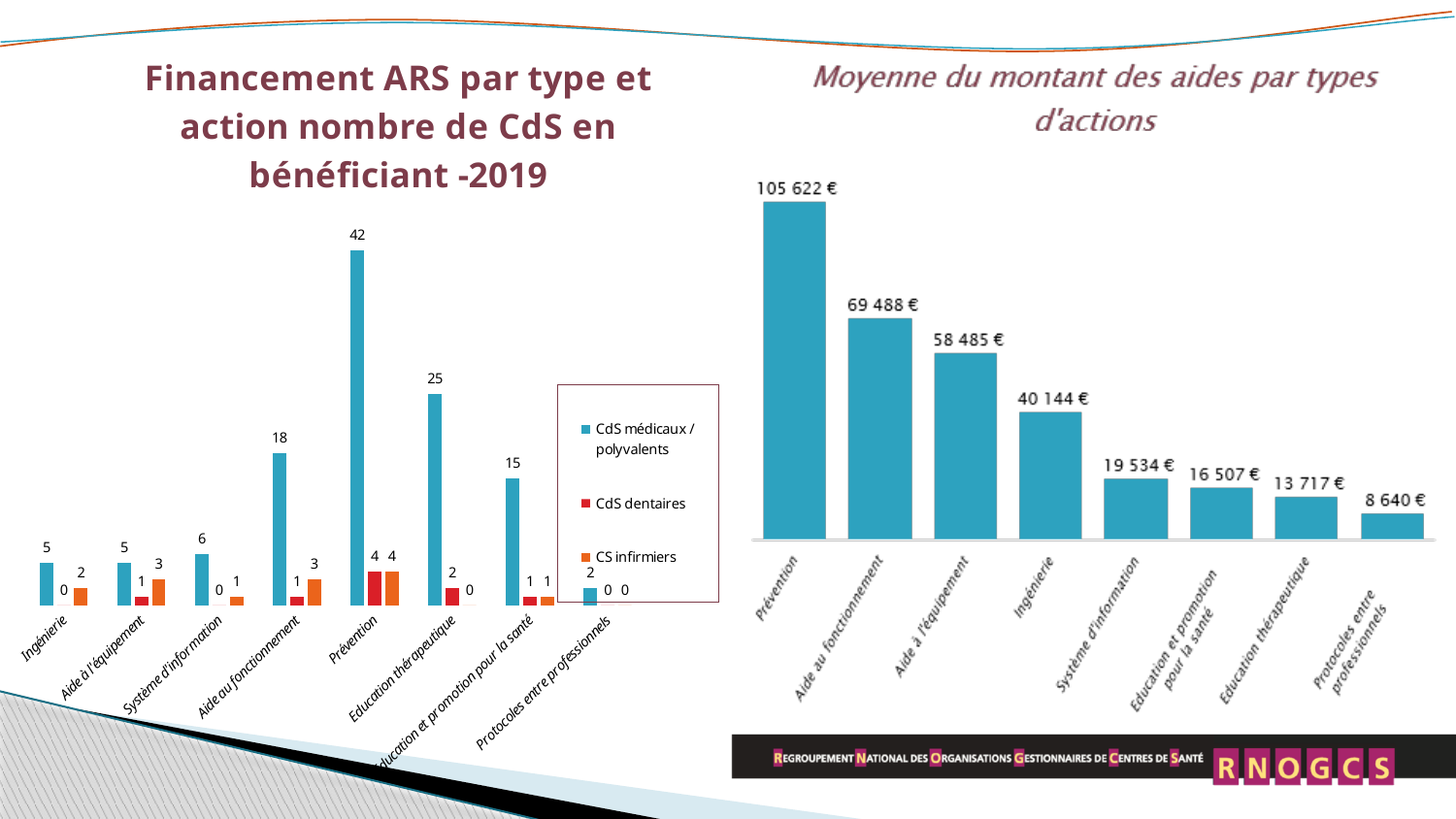
In the chart 'Financement ARS par type et action nombre de CdS en bénéficiant -2019', what is the difference between CdS médicaux / polyvalents in Prévention and in Education thérapeutique? 17 In the chart 'Financement ARS par type et action nombre de CdS en bénéficiant -2019', which is larger for CdS médicaux / polyvalents: Aide au fonctionnement or Education et promotion pour la santé? Aide au fonctionnement In the chart 'Moyenne du montant des aides par types d'actions', do the values rise or fall from left to right? fall In the chart 'Financement ARS par type et action nombre de CdS en bénéficiant -2019', what is the value for CdS médicaux / polyvalents in Prévention? 42 In the chart 'Moyenne du montant des aides par types d'actions', what is the value for Prévention? 105 622 € In the chart 'Moyenne du montant des aides par types d'actions', how many categories are shown? 8 What kind of chart is 'Moyenne du montant des aides par types d'actions'? bar chart In the chart 'Financement ARS par type et action nombre de CdS en bénéficiant -2019', how many series does the legend list? 3 In the chart 'Financement ARS par type et action nombre de CdS en bénéficiant -2019', what is the value for CS infirmiers in Aide au fonctionnement? 3 In the chart 'Financement ARS par type et action nombre de CdS en bénéficiant -2019', what colour represents CdS dentaires? red In the chart 'Moyenne du montant des aides par types d'actions', what is the value for Ingénierie? 40 144 € In the chart 'Moyenne du montant des aides par types d'actions', which category has the lowest value? Protocoles entre professionnels